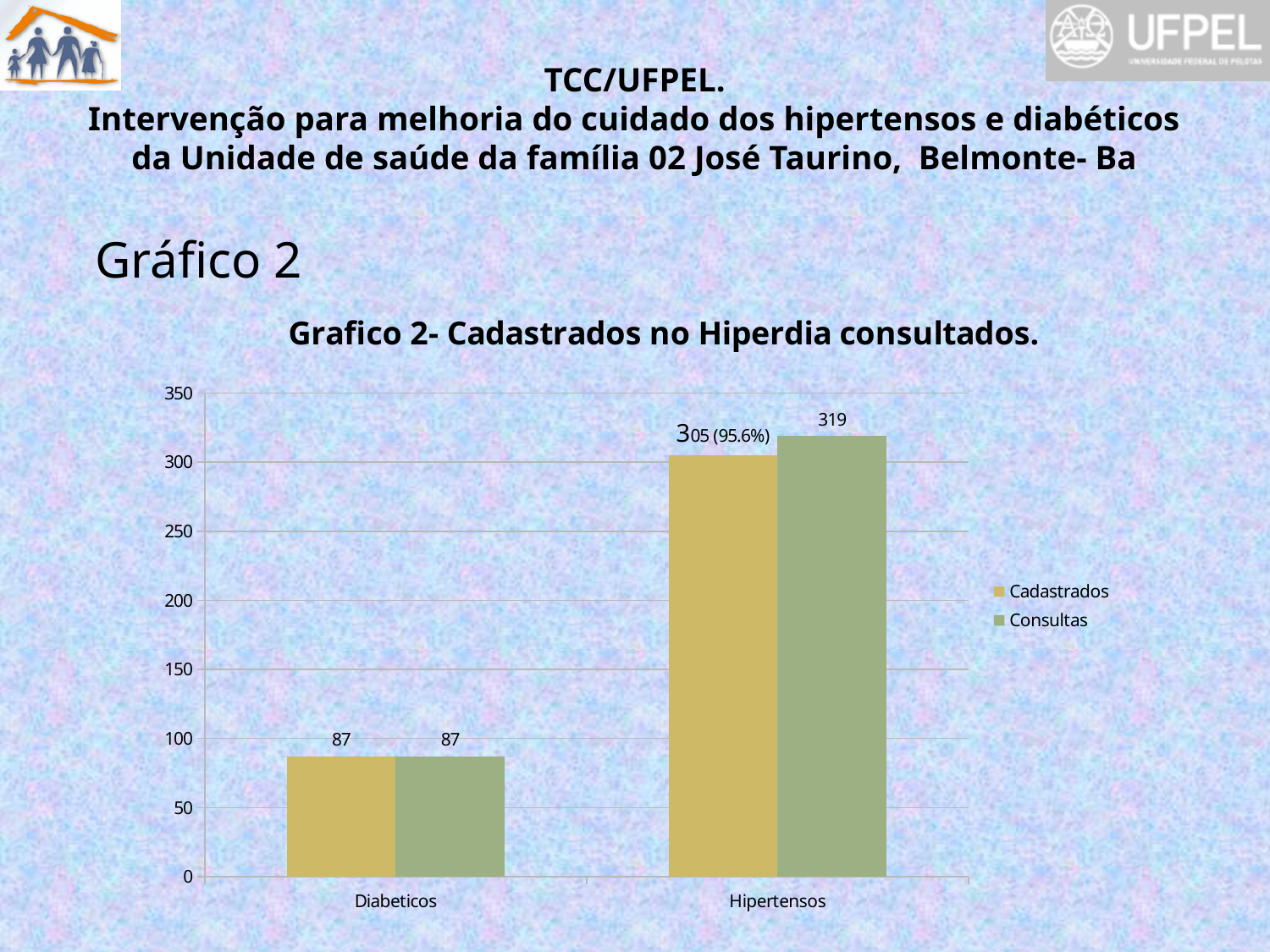
What is the Cadastrados value for Diabeticos? 87 How many series does the legend list? 2 What is the Consultas value for Hipertensos? 319 What is the title of the chart? Grafico 2- Cadastrados no Hiperdia consultados. What is the difference between the Consultas values for Hipertensos and Diabeticos? 232 Which category has the lowest Cadastrados value? Diabeticos Is the Consultas value for Hipertensos greater or less than 300? greater What is the data label shown on the Cadastrados bar for Hipertensos? 305 (95.6%) What is the Consultas value for Diabeticos? 87 What type of chart is shown on the slide? bar chart How many categories are shown on the x axis? 2 Which category has the highest Consultas value? Hipertensos